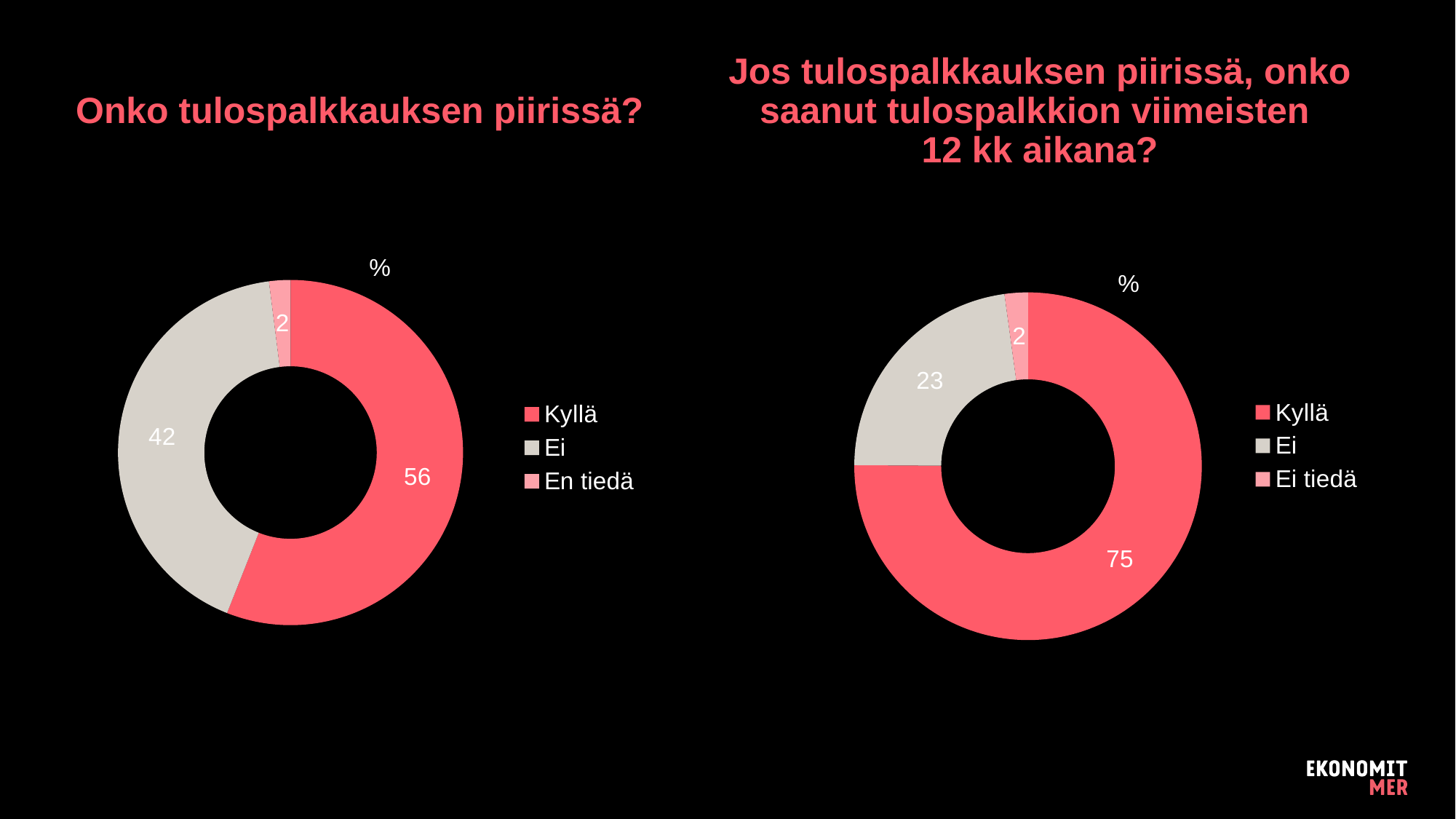
In the left chart 'Onko tulospalkkauksen piirissä?', what is the value for Kyllä? 56 In the right chart 'Jos tulospalkkauksen piirissä, onko saanut tulospalkkion viimeisten 12 kk aikana?', what is the value for Kyllä? 75 In the right chart 'Jos tulospalkkauksen piirissä, onko saanut tulospalkkion viimeisten 12 kk aikana?', what is the value for Ei? 23 In the left chart 'Onko tulospalkkauksen piirissä?', what is the difference between the values for Kyllä and Ei? 14 In the left chart 'Onko tulospalkkauksen piirissä?', what is the value for En tiedä? 2 In the right chart 'Jos tulospalkkauksen piirissä, onko saanut tulospalkkion viimeisten 12 kk aikana?', what is the difference between the values for Kyllä and Ei? 52 In the right chart 'Jos tulospalkkauksen piirissä, onko saanut tulospalkkion viimeisten 12 kk aikana?', which category has the smallest share? Ei tiedä Which chart has the larger value for Kyllä, the left chart or the right chart? the right chart How many categories does the legend of the right chart 'Jos tulospalkkauksen piirissä, onko saanut tulospalkkion viimeisten 12 kk aikana?' list? 3 What kind of chart is the left chart 'Onko tulospalkkauksen piirissä?'? doughnut chart In the left chart 'Onko tulospalkkauksen piirissä?', which category has the largest share? Kyllä In the left chart 'Onko tulospalkkauksen piirissä?', what is the value for Ei? 42